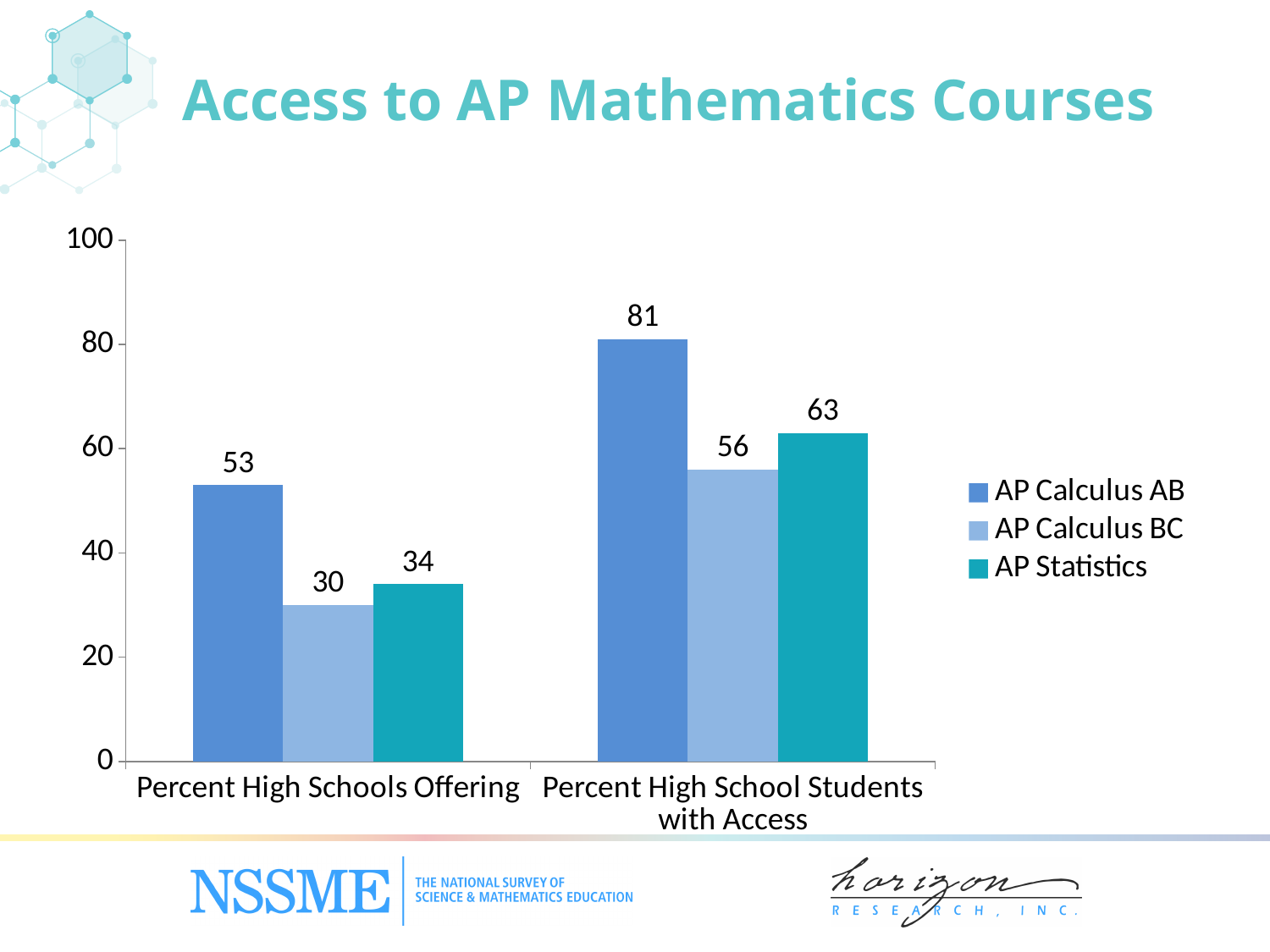
What is the title of the slide? Access to AP Mathematics Courses What is the value for AP Statistics in the Percent High School Students with Access category? 63 How many series does the legend list? 3 What kind of chart is shown on the slide? Bar chart Which series has the highest value in the Percent High School Students with Access category? AP Calculus AB What is the value for AP Calculus AB in the Percent High Schools Offering category? 53 What is the difference between the AP Calculus AB values for Percent High School Students with Access and Percent High Schools Offering? 28 Which is larger: AP Statistics for Percent High Schools Offering or AP Calculus BC for Percent High School Students with Access? AP Calculus BC for Percent High School Students with Access What is the value for AP Calculus BC in the Percent High Schools Offering category? 30 Which series has the lowest value in the Percent High Schools Offering category? AP Calculus BC What is the difference between the AP Statistics and AP Calculus BC values in the Percent High School Students with Access category? 7 How many categories are shown on the x axis? 2